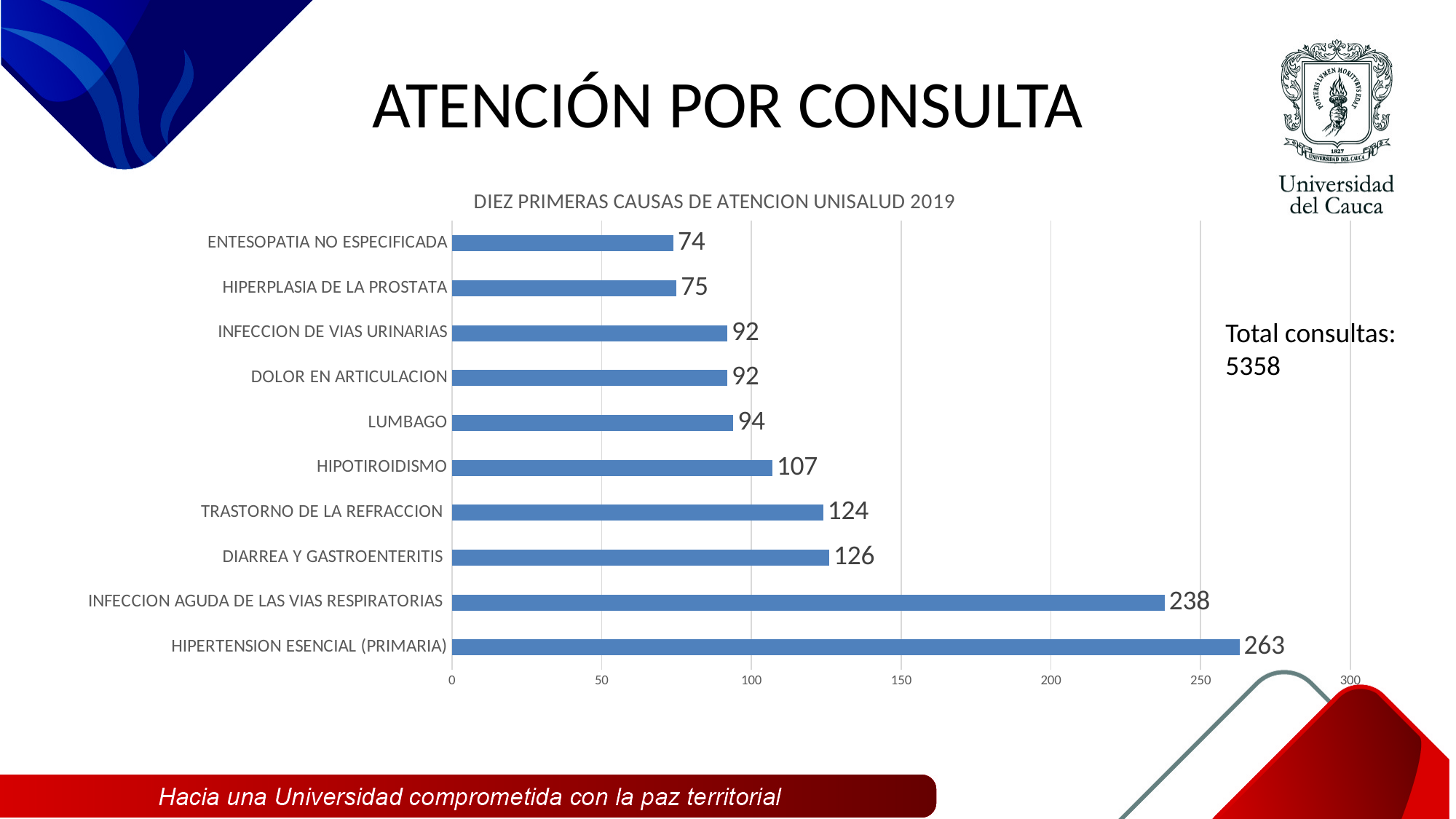
What is the difference between the values for HIPERTENSION ESENCIAL (PRIMARIA) and INFECCION AGUDA DE LAS VIAS RESPIRATORIAS? 25 What is the title of the chart? DIEZ PRIMERAS CAUSAS DE ATENCION UNISALUD 2019 Which category has the highest value? HIPERTENSION ESENCIAL (PRIMARIA) How many categories are shown in the chart? 10 What is the value for HIPOTIROIDISMO? 107 Is the value for DIARREA Y GASTROENTERITIS greater or less than 150? less Which is larger, the value for TRASTORNO DE LA REFRACCION or the value for HIPOTIROIDISMO? TRASTORNO DE LA REFRACCION What is the value for LUMBAGO? 94 What is the value for HIPERTENSION ESENCIAL (PRIMARIA)? 263 What is the value for INFECCION AGUDA DE LAS VIAS RESPIRATORIAS? 238 What kind of chart is shown on the slide? bar chart Which category has the lowest value? ENTESOPATIA NO ESPECIFICADA